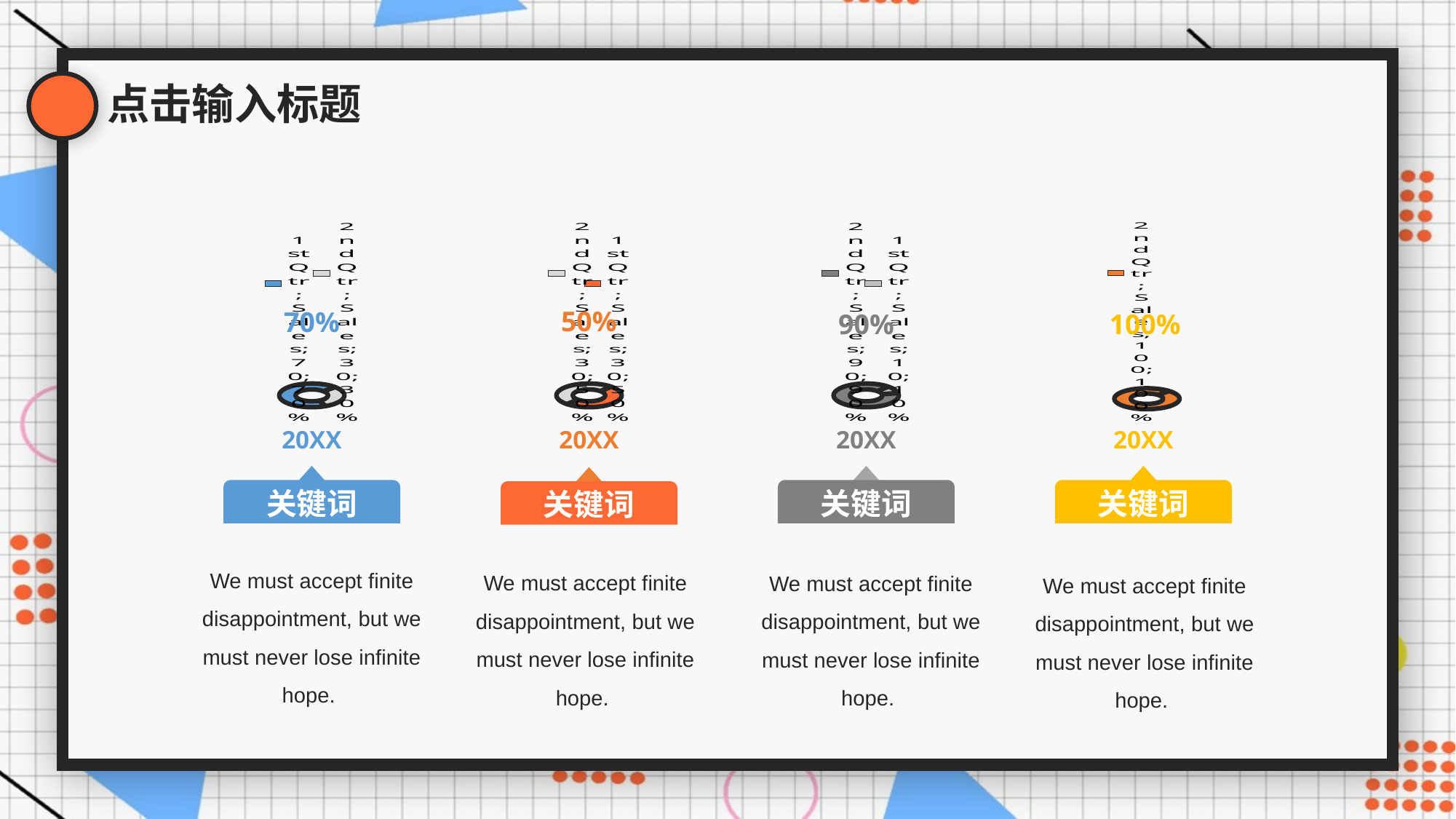
What kind of chart is used for each of the four small charts on the slide? Doughnut (pie) chart What percentage is shown above the second doughnut chart from the left? 50% Which of the four charts shows the lowest percentage? The second chart from the left, 50% What percentage is shown above the first (leftmost) doughnut chart? 70% What colour is the highlighted segment of the second chart from the left? Orange What percentage is shown above the third doughnut chart from the left? 90% Which is larger, the percentage of the first chart or the third chart? The third chart (90%) How many doughnut charts are on the slide? 4 Which of the four charts shows the highest percentage? The fourth (rightmost) chart, 100% What percentage is shown above the fourth (rightmost) doughnut chart? 100% What is the difference between the percentage of the rightmost chart and the leftmost chart? 30% What year label appears below each of the four charts? 20XX